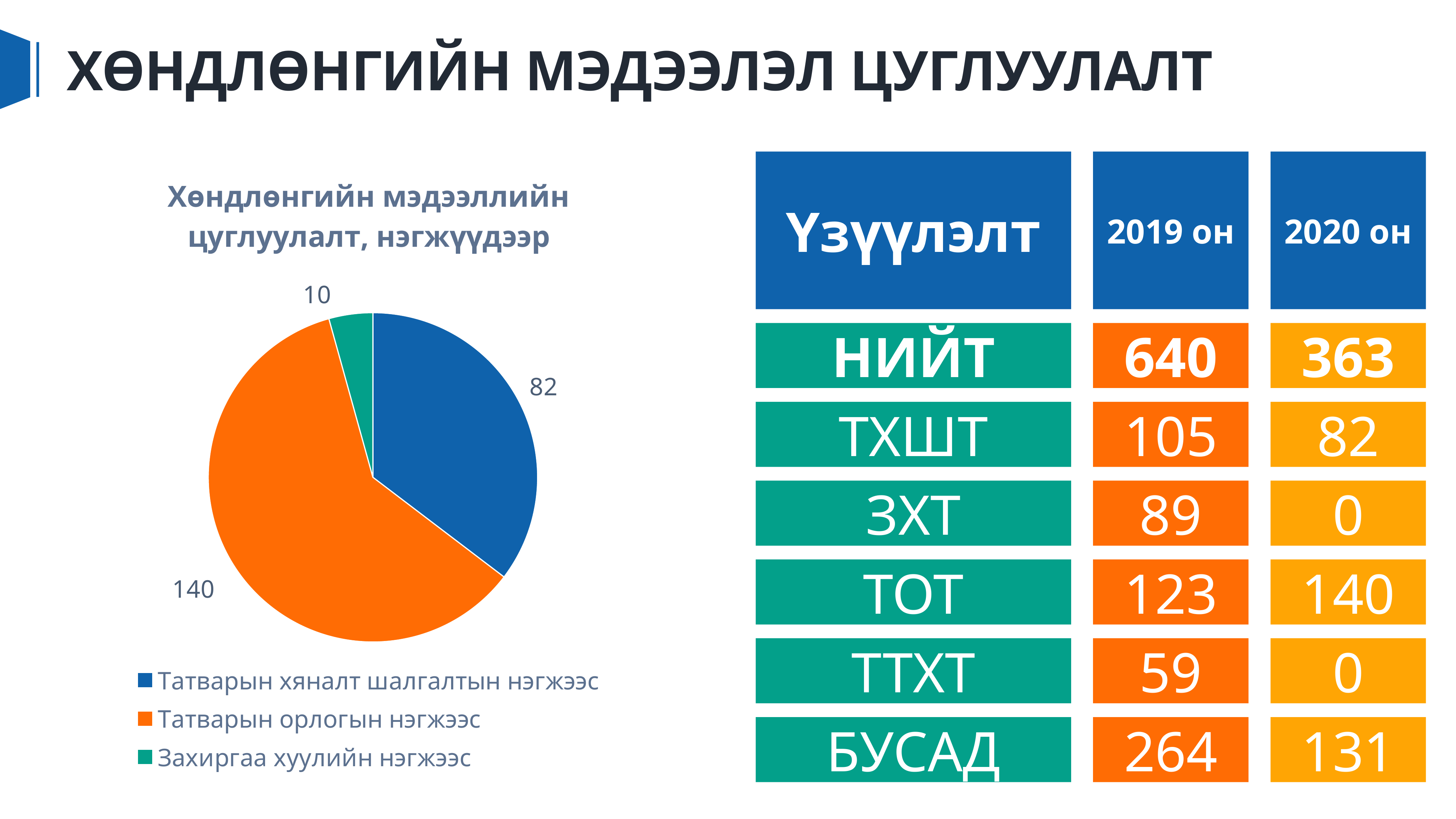
What is the difference between the values for Татварын орлогын нэгжээс and Татварын хяналт шалгалтын нэгжээс? 58 What kind of chart is shown on the slide? pie chart What is the value for Захиргаа хуулийн нэгжээс in the pie chart? 10 What colour is the slice for Татварын орлогын нэгжээс in the pie chart? orange What is the total of all slices in the pie chart? 232 What is the value for Татварын хяналт шалгалтын нэгжээс in the pie chart? 82 Which category has the smallest slice in the pie chart? Захиргаа хуулийн нэгжээс Which is larger: the value for Татварын хяналт шалгалтын нэгжээс or the value for Захиргаа хуулийн нэгжээс? Татварын хяналт шалгалтын нэгжээс How many slices does the pie chart have? 3 Which category has the largest slice in the pie chart? Татварын орлогын нэгжээс What is the value for Татварын орлогын нэгжээс in the pie chart? 140 What is the title of the pie chart? Хөндлөнгийн мэдээллийн цуглуулалт, нэгжүүдээр